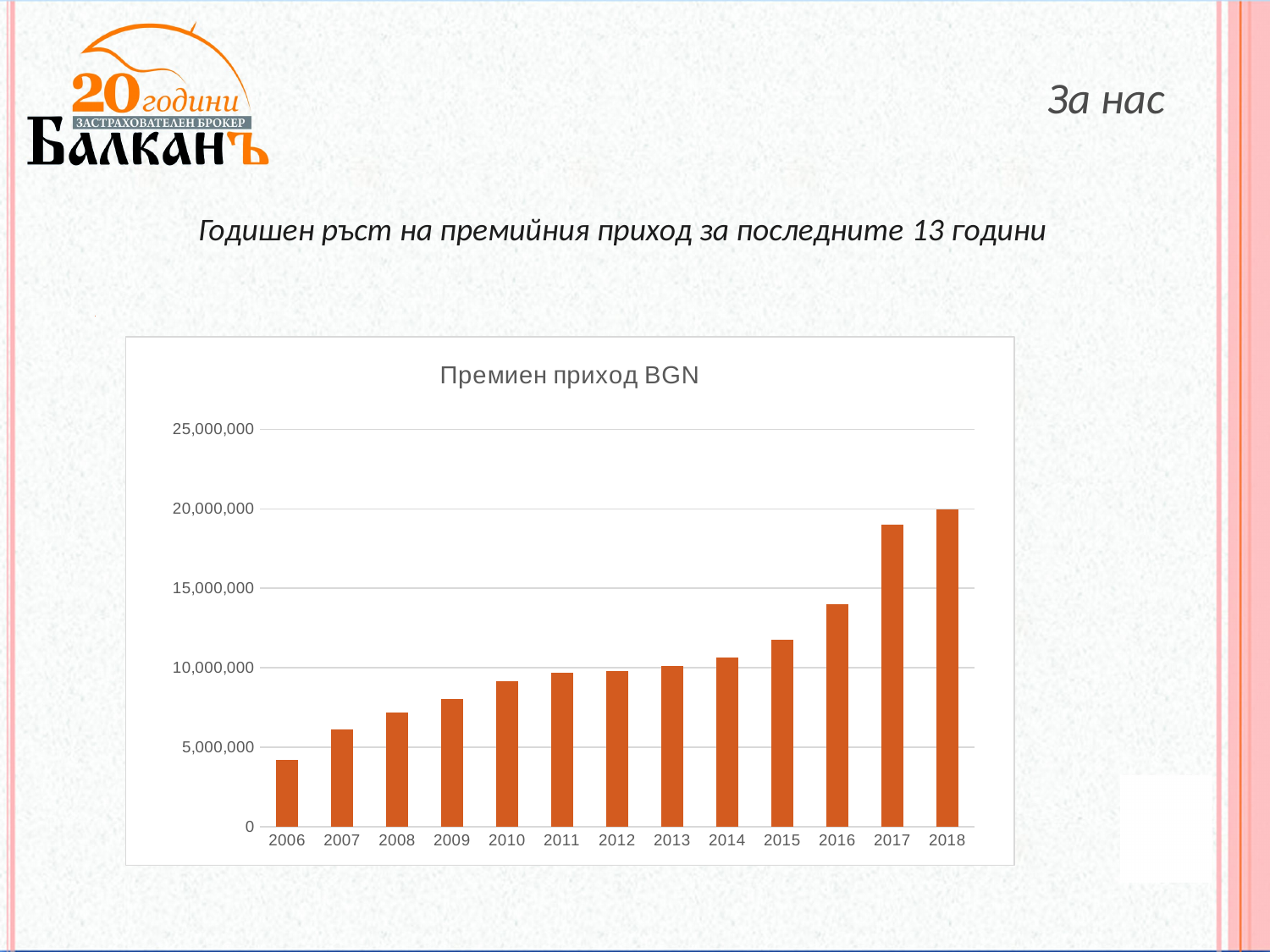
Which year has the highest premium income? 2018 Is the value for 2017 greater or less than 15,000,000? greater What is the title of the chart? Премиен приход BGN What kind of chart is shown on the slide? bar chart Which year has the lowest premium income? 2006 Is the value for 2011 greater or less than 10,000,000? less How many years are shown on the x axis of the chart? 13 Which year has the larger value, 2016 or 2017? 2017 Is the value for 2015 greater or less than 10,000,000? greater Do the values generally rise or fall from 2006 to 2018? rise What is the first year shown on the x axis? 2006